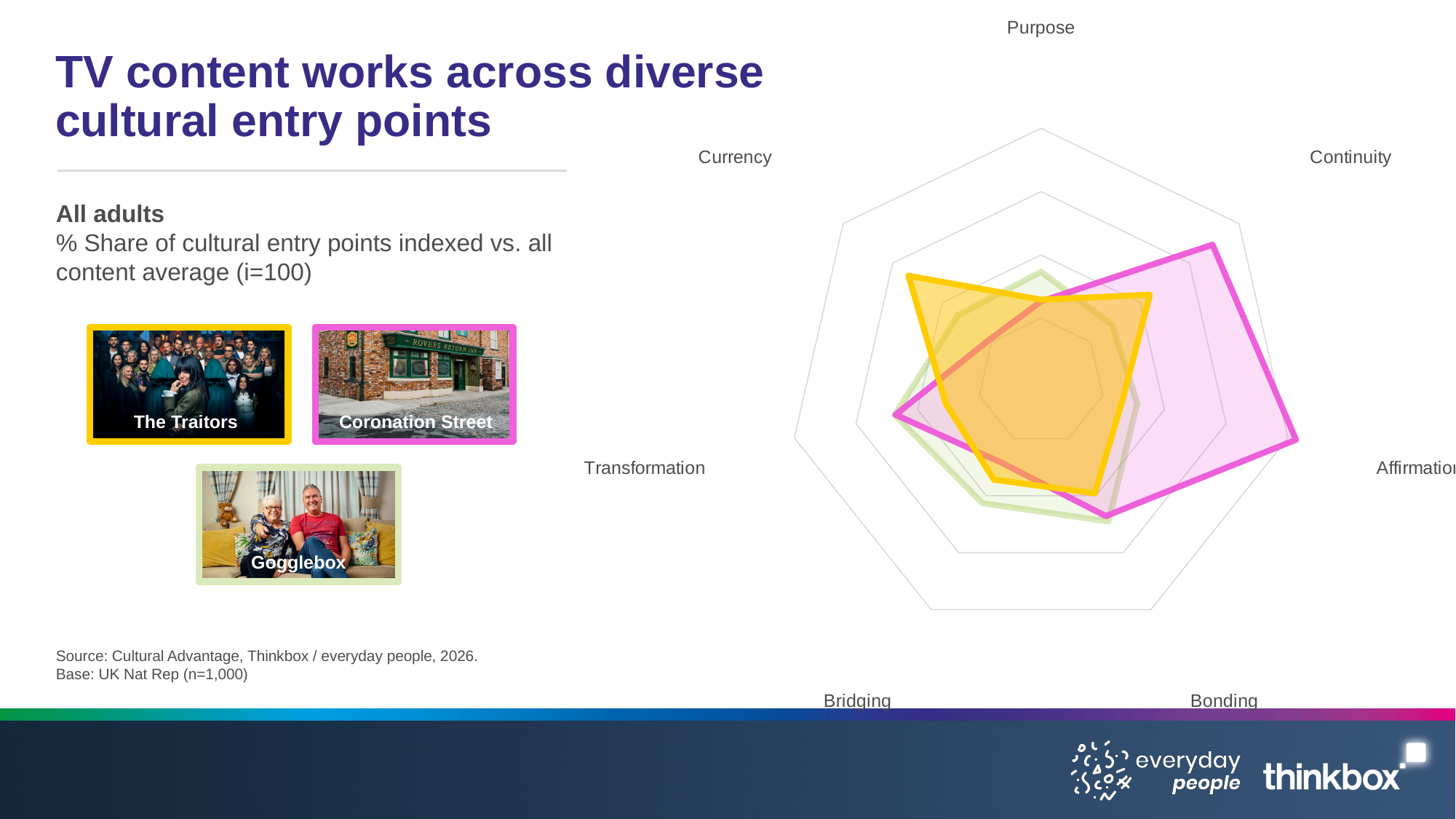
Which programme has the highest value on the Currency axis? The Traitors Which programme has the lowest value on the Currency axis? Coronation Street Which programme has the highest value on the Continuity axis? Coronation Street On the Affirmation axis, which is larger: Coronation Street or Gogglebox? Coronation Street How many cultural entry point axes does the radar chart have? 7 Which programme has the highest value on the Affirmation axis? Coronation Street Which colour represents Coronation Street on the radar chart? Pink On the Currency axis, which is larger: The Traitors or Coronation Street? The Traitors How many TV programmes (series) are plotted on the radar chart? 3 What kind of chart is shown on the slide? Radar chart Which programme has the lowest value on the Continuity axis? Gogglebox Which audience does the chart cover, according to the subtitle? All adults